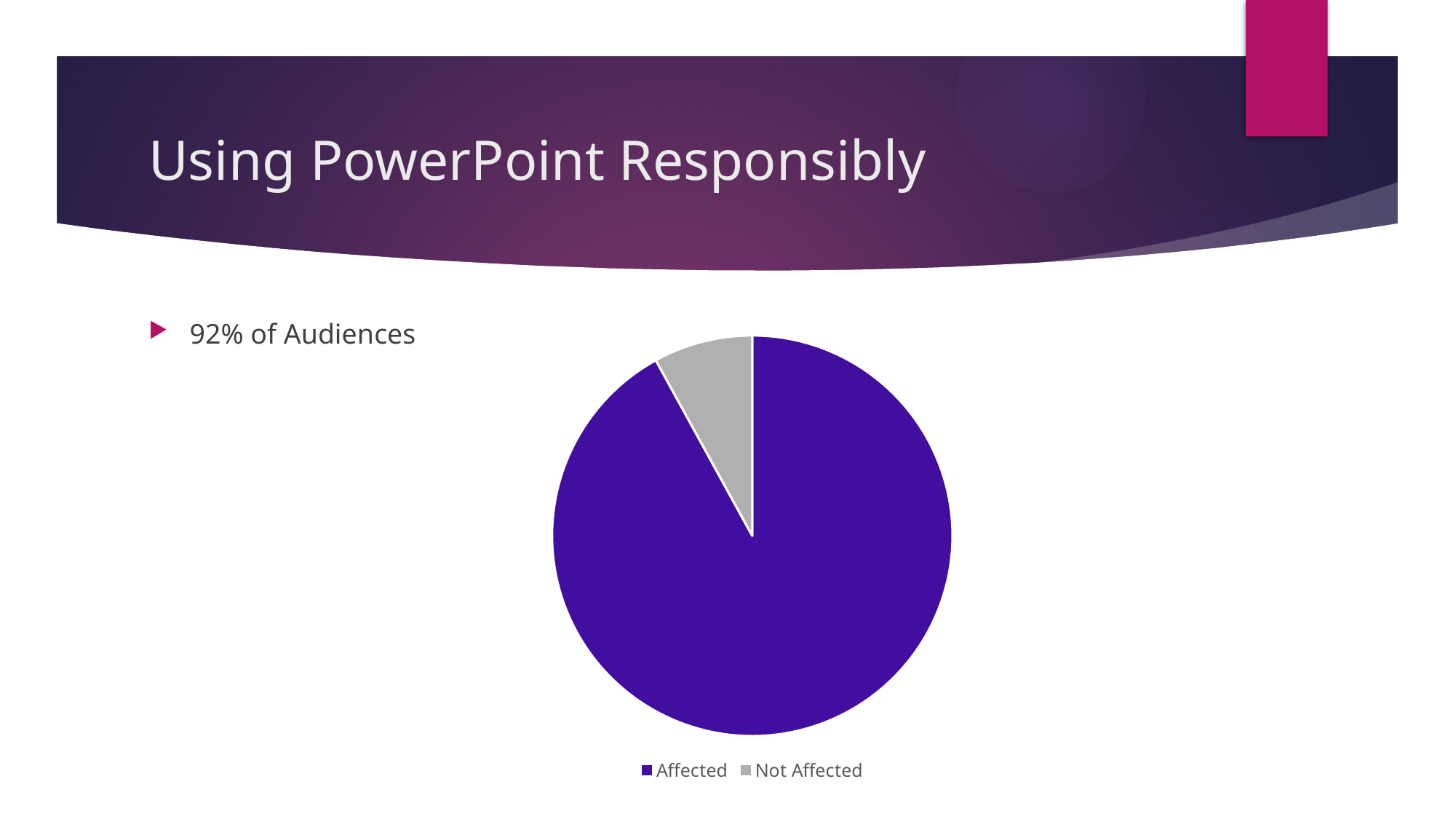
Which slice of the pie chart is the largest? Affected What are the two legend entries of the pie chart? Affected, Not Affected Which slice is larger in the pie chart, Affected or Not Affected? Affected What colour is the Affected slice in the pie chart? purple Which slice of the pie chart is the smallest? Not Affected How many entries does the legend of the pie chart list? 2 What kind of chart is shown on the slide? pie chart How many slices does the pie chart have? 2 Does the Affected slice take up more or less than half of the pie chart? more